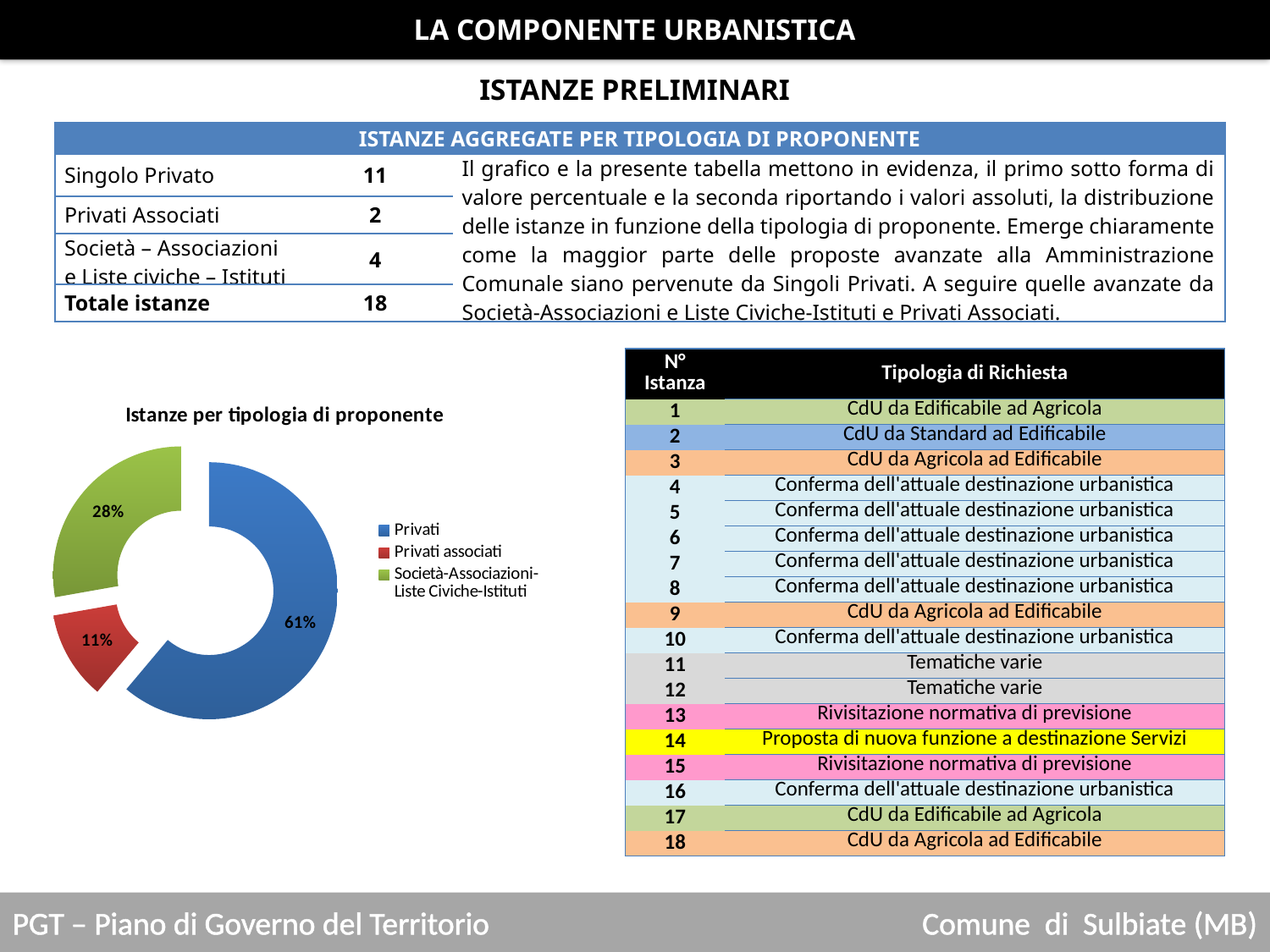
How many categories does the chart 'Istanze per tipologia di proponente' show? 3 In the chart 'Istanze per tipologia di proponente', which is larger: the share for Privati associati or the share for Società-Associazioni-Liste Civiche-Istituti? Società-Associazioni-Liste Civiche-Istituti What kind of chart is 'Istanze per tipologia di proponente'? doughnut chart In the chart 'Istanze per tipologia di proponente', what colour is the Privati slice? blue In the chart 'Istanze per tipologia di proponente', what percentage is shown for Privati associati? 11% Which category has the smallest share in the chart 'Istanze per tipologia di proponente'? Privati associati In the chart 'Istanze per tipologia di proponente', what percentage is shown for Società-Associazioni-Liste Civiche-Istituti? 28% In the chart 'Istanze per tipologia di proponente', what is the difference between the Società-Associazioni-Liste Civiche-Istituti share and the Privati associati share? 17 percentage points In the chart 'Istanze per tipologia di proponente', what percentage is shown for Privati? 61% In the chart 'Istanze per tipologia di proponente', how many percentage points larger is the Privati share than the Società-Associazioni-Liste Civiche-Istituti share? 33 percentage points Which category has the largest share in the chart 'Istanze per tipologia di proponente'? Privati How many entries does the legend of the chart 'Istanze per tipologia di proponente' list? 3